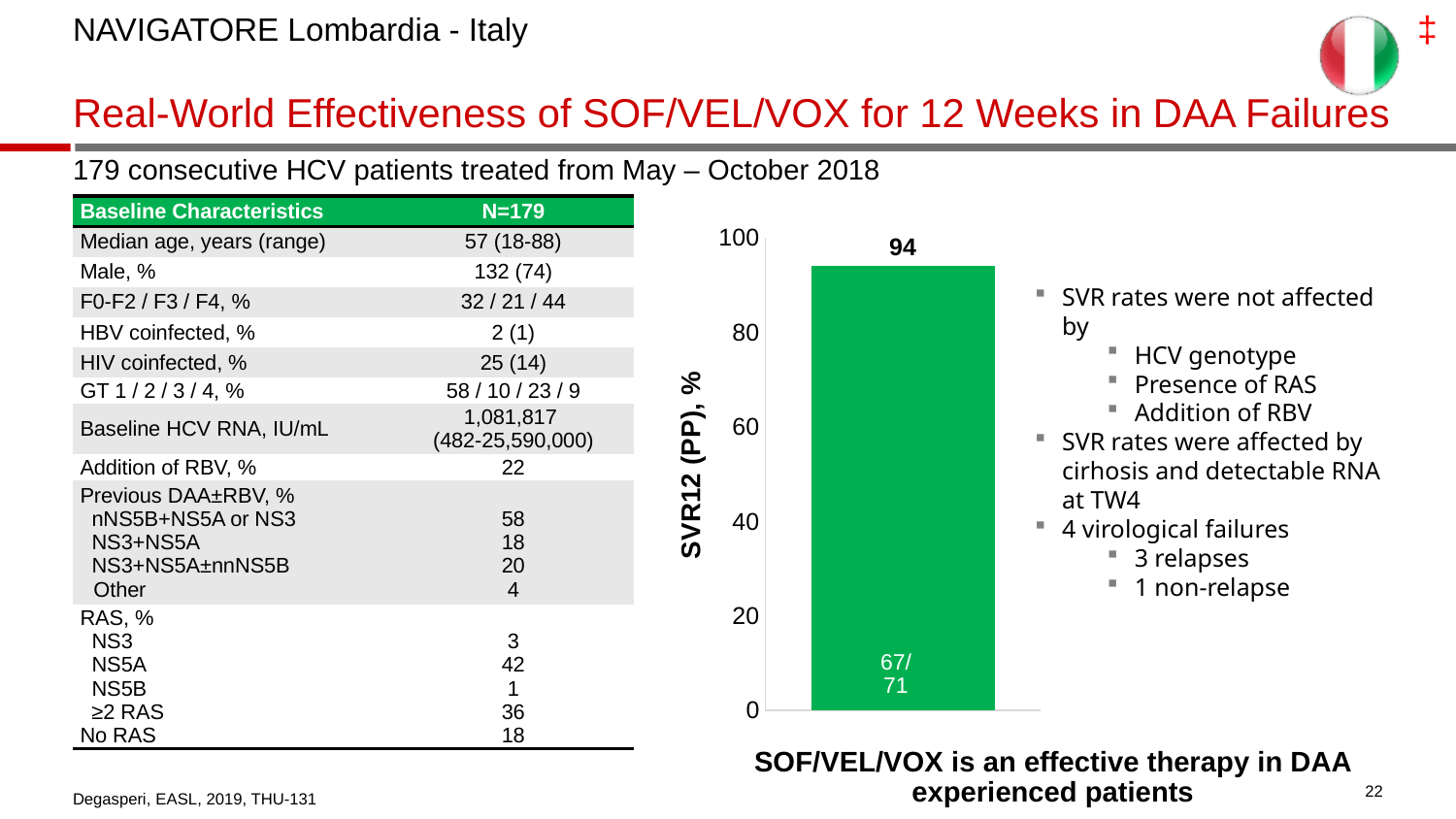
How many patients were in the per-protocol denominator according to the fraction printed on the bar? 71 Is the SVR12 value shown in the chart greater or less than 80? greater How many patients achieved SVR12 according to the fraction printed on the bar? 67 What is the label of the y axis of the chart? SVR12 (PP), % What fraction is printed inside the bar of the SVR12 chart? 67/71 How many bars are plotted in the chart? 1 Is the SVR12 value shown in the chart greater or less than 100? less What is the maximum value shown on the y axis of the chart? 100 What SVR12 (PP) percentage is shown on the bar chart? 94 What kind of chart is shown on the slide? bar chart